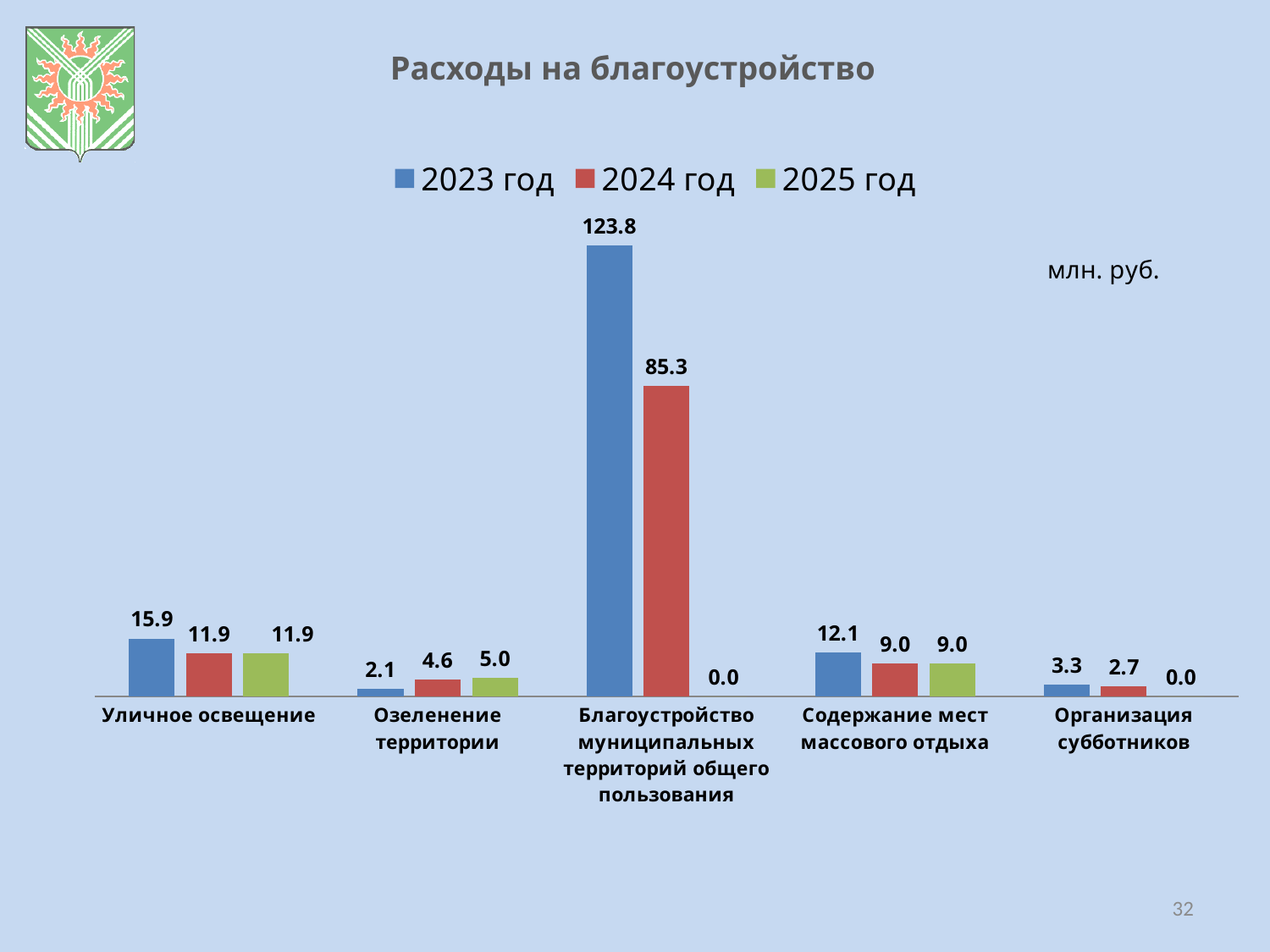
What kind of chart is shown on the slide? bar chart What is the value for 2024 год for Организация субботников? 2.7 What is the value for 2025 год for Озеленение территории? 5.0 What is the value for 2023 год for Благоустройство муниципальных территорий общего пользования? 123.8 What is the difference between the 2023 год and 2025 год values for Уличное освещение? 4.0 Which category has the lowest value for 2023 год? Озеленение территории How many series does the legend list? 3 How many categories are shown on the x axis? 5 What is the difference between the 2023 год and 2024 год values for Благоустройство муниципальных территорий общего пользования? 38.5 What is the title of the chart? Расходы на благоустройство Which category has the highest value for 2024 год? Благоустройство муниципальных территорий общего пользования Which is larger for Содержание мест массового отдыха: the 2023 год value or the 2024 год value? 2023 год